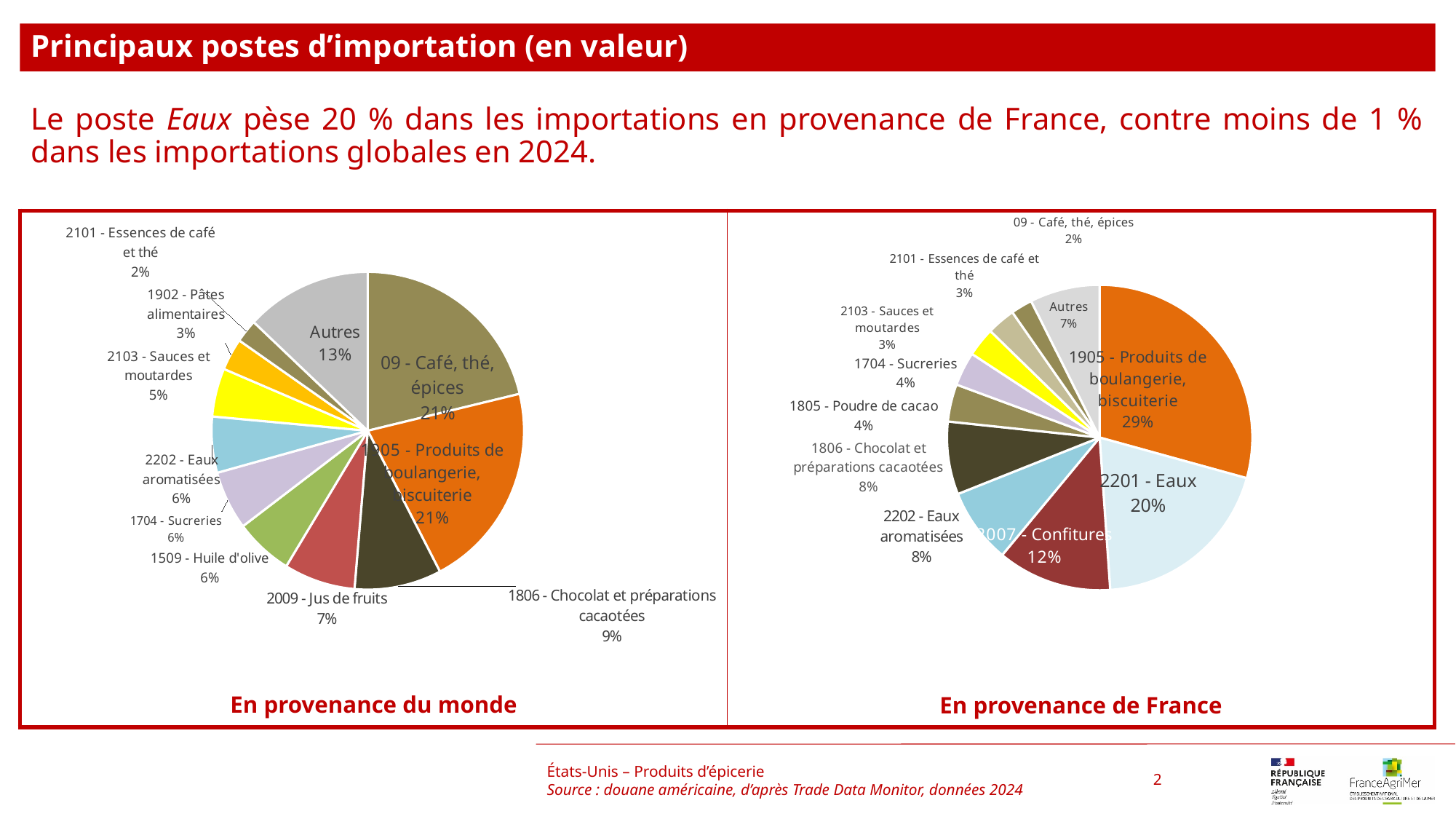
In the 'En provenance de France' chart, what share does '2007 - Confitures' have? 12% What is the caption under the left pie chart? En provenance du monde In the 'En provenance du monde' chart, what share does '1806 - Chocolat et préparations cacaotées' have? 9% What kind of chart is used in the 'En provenance du monde' panel? pie chart In the 'En provenance de France' chart, what is the difference between the shares of '1905 - Produits de boulangerie, biscuiterie' and '2201 - Eaux'? 9 percentage points How many slices does the 'En provenance de France' pie chart have? 11 In the 'En provenance de France' chart, which category has the largest share? 1905 - Produits de boulangerie, biscuiterie In the 'En provenance du monde' chart, which category has the smallest share? 2101 - Essences de café et thé In the 'En provenance de France' chart, which category has the smallest share? 09 - Café, thé, épices In the 'En provenance de France' chart, what share does '2201 - Eaux' have? 20% In the 'En provenance du monde' chart, what share does 'Autres' have? 13% In the 'En provenance du monde' chart, which is larger: '2009 - Jus de fruits' or '2103 - Sauces et moutardes'? 2009 - Jus de fruits